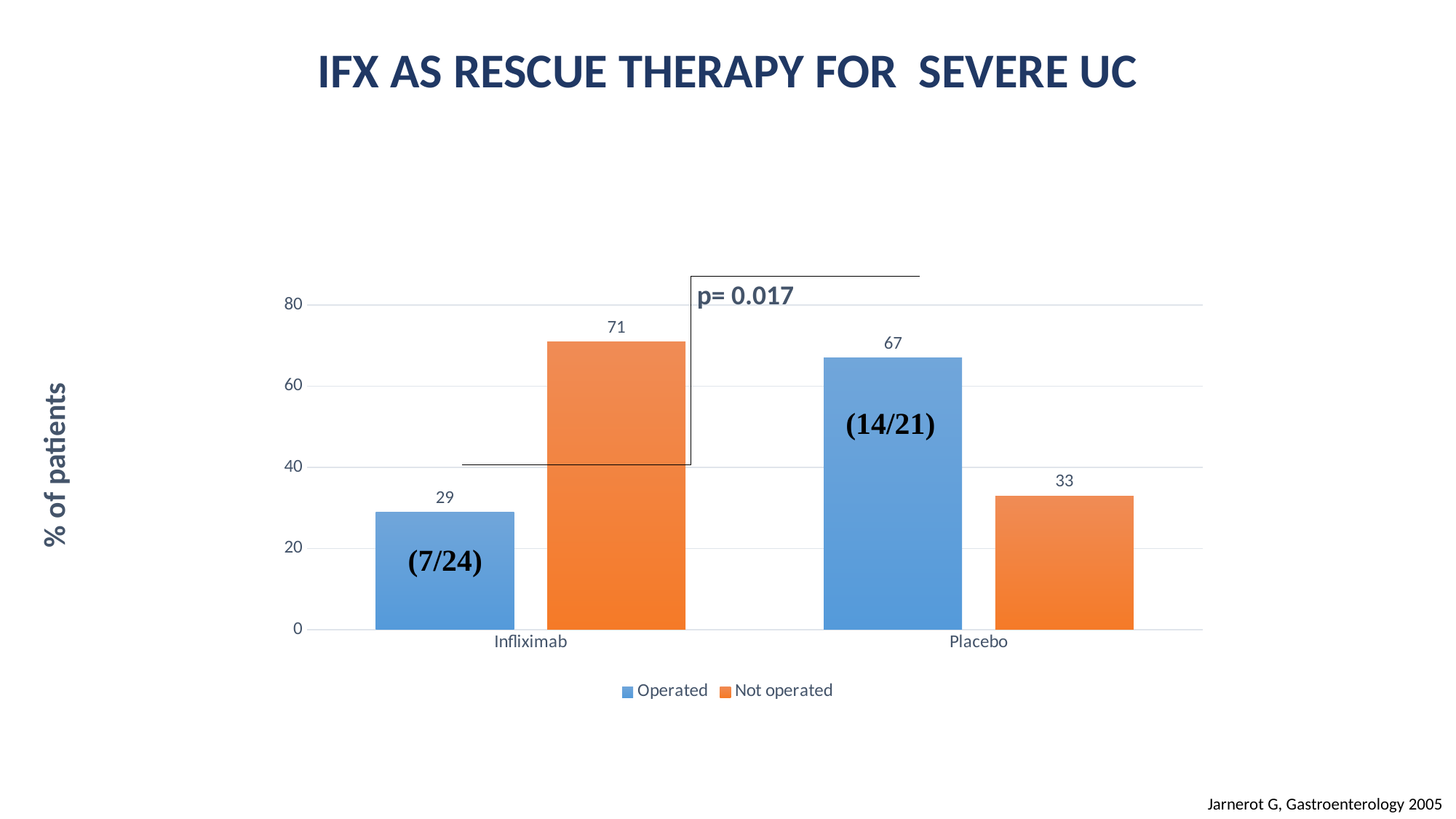
What is the difference between the Not operated and Operated values in the Infliximab group? 42 What p-value is shown on the chart? p= 0.017 What is the value for Not operated in the Infliximab group? 71 What percentage of patients in the Placebo group were not operated? 33 What is the difference between the Operated percentages for Placebo and Infliximab? 38 Which group has the higher percentage of operated patients, Infliximab or Placebo? Placebo How many series does the legend list? 2 What type of chart is shown on the slide? Bar chart Which bar in the chart has the lowest value? Operated, Infliximab (29) What percentage of patients in the Infliximab group were operated? 29 Which bar in the chart has the highest value? Not operated, Infliximab (71) What is the value for Operated in the Placebo group? 67